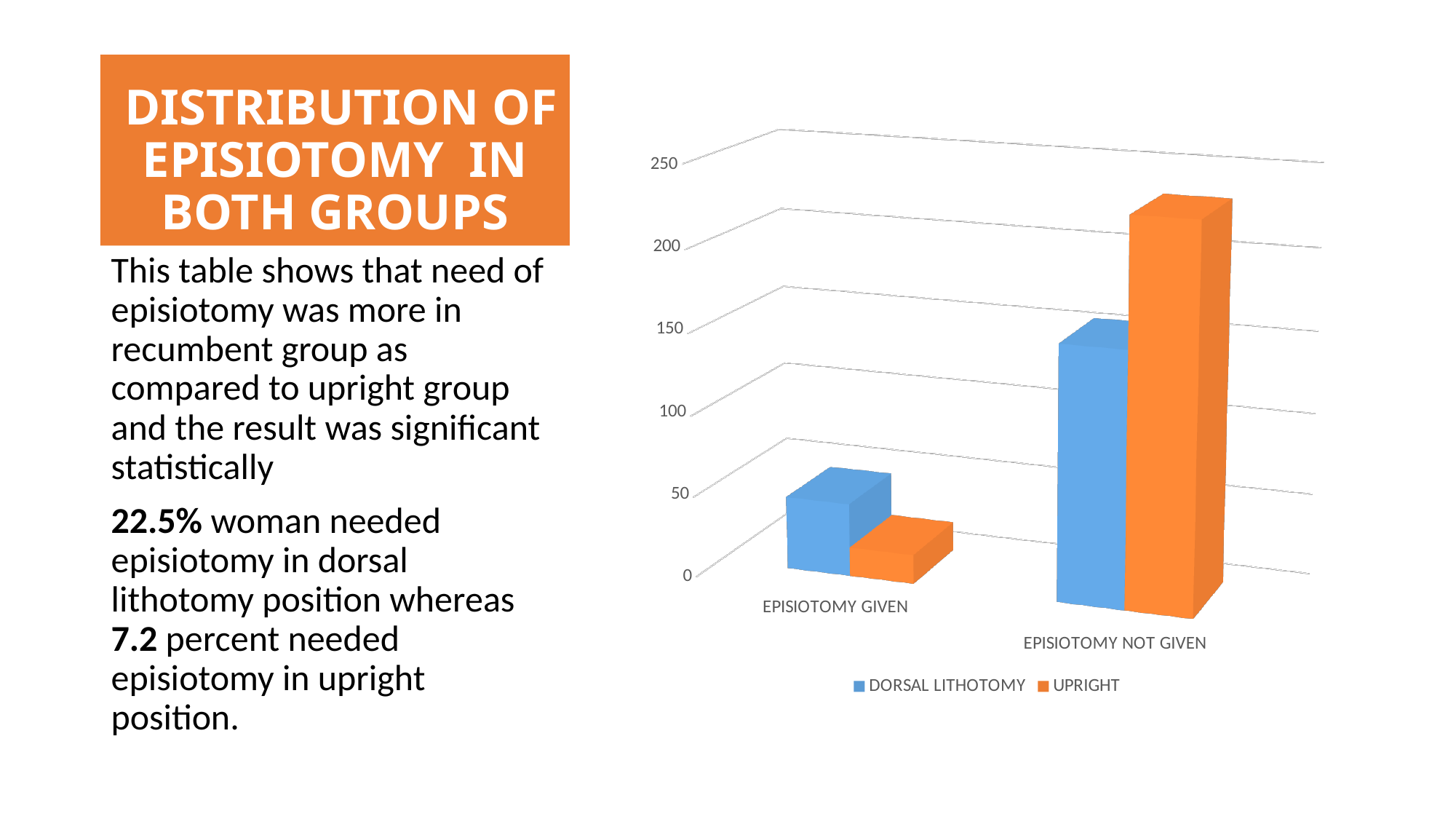
In the EPISIOTOMY NOT GIVEN category, which series has the larger value, DORSAL LITHOTOMY or UPRIGHT? UPRIGHT Which series does the orange colour represent in the chart? UPRIGHT How many series does the chart legend list? 2 Is the DORSAL LITHOTOMY value for EPISIOTOMY NOT GIVEN greater or less than 100? greater Is the UPRIGHT value for EPISIOTOMY NOT GIVEN greater or less than 150? greater What kind of chart is shown on the slide? bar chart Which series has the lowest bar in the EPISIOTOMY GIVEN category? UPRIGHT In the EPISIOTOMY GIVEN category, which series has the larger value, DORSAL LITHOTOMY or UPRIGHT? DORSAL LITHOTOMY How many categories are shown on the x axis of the chart? 2 Do the UPRIGHT values rise or fall from EPISIOTOMY GIVEN to EPISIOTOMY NOT GIVEN? rise Which category has the tallest bar in the chart? EPISIOTOMY NOT GIVEN Is the DORSAL LITHOTOMY value for EPISIOTOMY GIVEN greater or less than 100? less